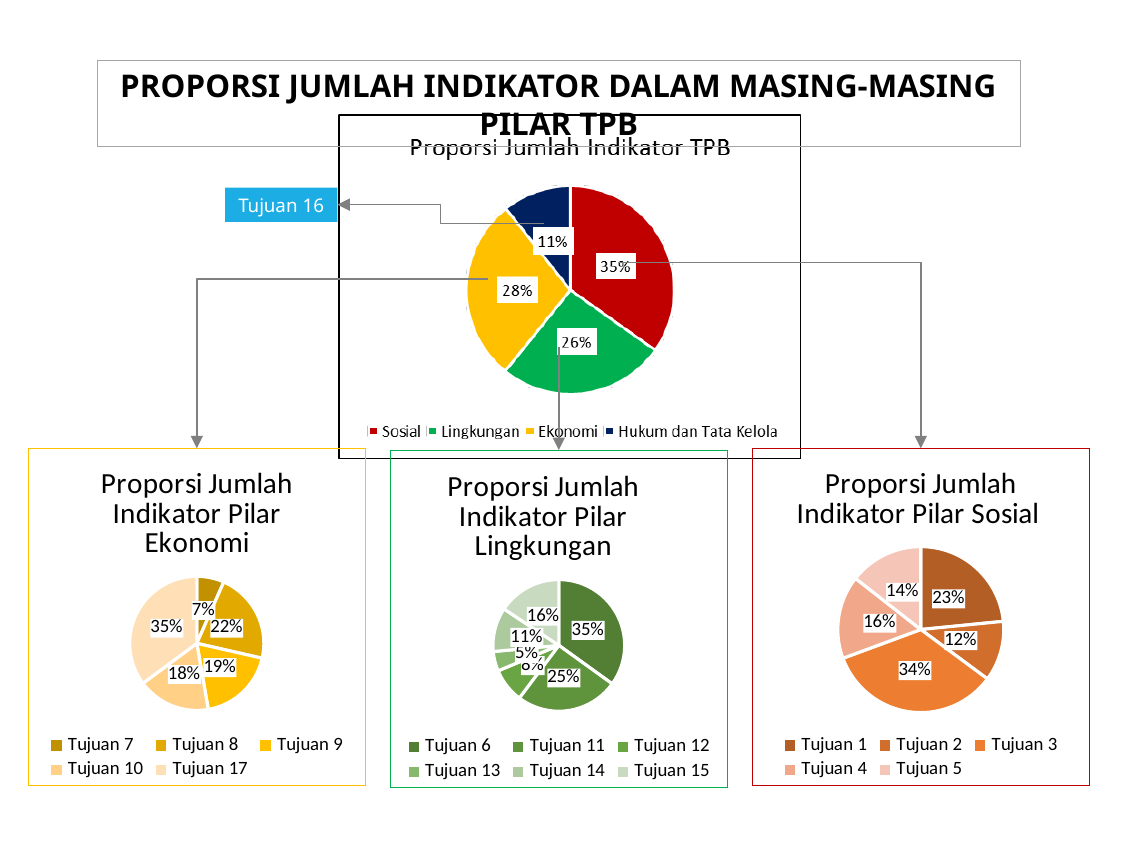
In the 'Proporsi Jumlah Indikator Pilar Lingkungan' pie chart, what share does Tujuan 6 have? 35% In the 'Proporsi Jumlah Indikator TPB' pie chart, what share does Sosial have? 35% In the 'Proporsi Jumlah Indikator TPB' pie chart, what is the difference between the Ekonomi and Lingkungan shares? 2% What type of chart is 'Proporsi Jumlah Indikator Pilar Sosial'? Pie chart In the 'Proporsi Jumlah Indikator Pilar Ekonomi' pie chart, which is larger, Tujuan 8 or Tujuan 9? Tujuan 8 In the 'Proporsi Jumlah Indikator Pilar Ekonomi' pie chart, which Tujuan has the largest share? Tujuan 17 How many Tujuan categories does the legend of the 'Proporsi Jumlah Indikator Pilar Lingkungan' pie chart list? 6 In the 'Proporsi Jumlah Indikator Pilar Ekonomi' pie chart, what share does Tujuan 7 have? 7% In the 'Proporsi Jumlah Indikator Pilar Sosial' pie chart, which Tujuan has the smallest share? Tujuan 2 In the 'Proporsi Jumlah Indikator TPB' pie chart, which category has the smallest share? Hukum dan Tata Kelola How many categories does the legend of the 'Proporsi Jumlah Indikator TPB' pie chart list? 4